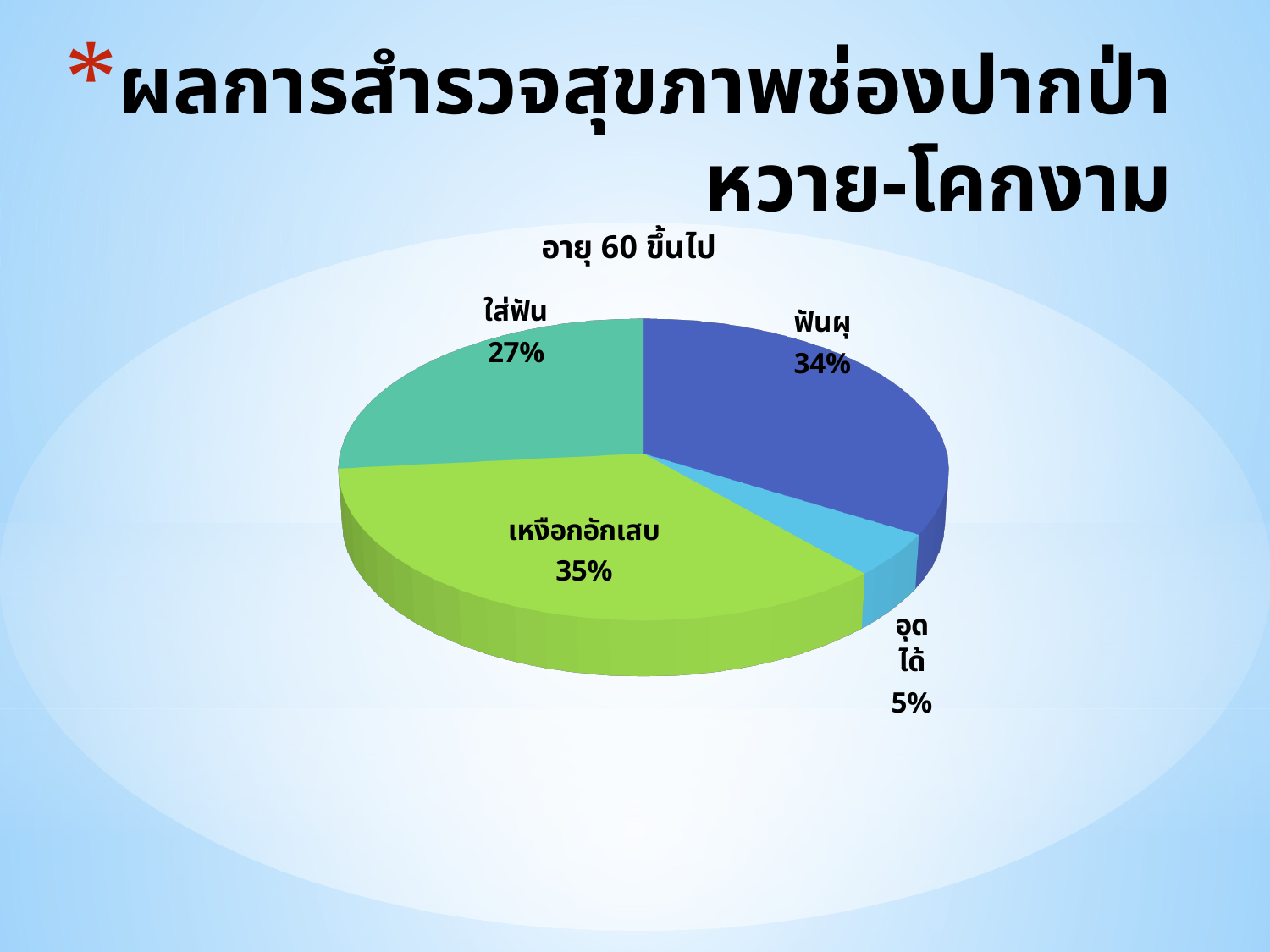
What is the title of the chart? อายุ 60 ขึ้นไป What percentage of the pie is เหงือกอักเสบ? 35% What is the difference between the ฟันผุ and ใส่ฟัน percentages? 7% Which slice of the pie is the smallest? อุดได้ What percentage of the pie is อุดได้? 5% How many slices does the pie chart have? 4 What colour is the เหงือกอักเสบ slice? green What kind of chart is shown on the slide? pie chart Which slice of the pie is the largest? เหงือกอักเสบ What percentage of the pie is ใส่ฟัน? 27% Which is larger, the ใส่ฟัน slice or the อุดได้ slice? ใส่ฟัน What percentage of the pie is ฟันผุ? 34%